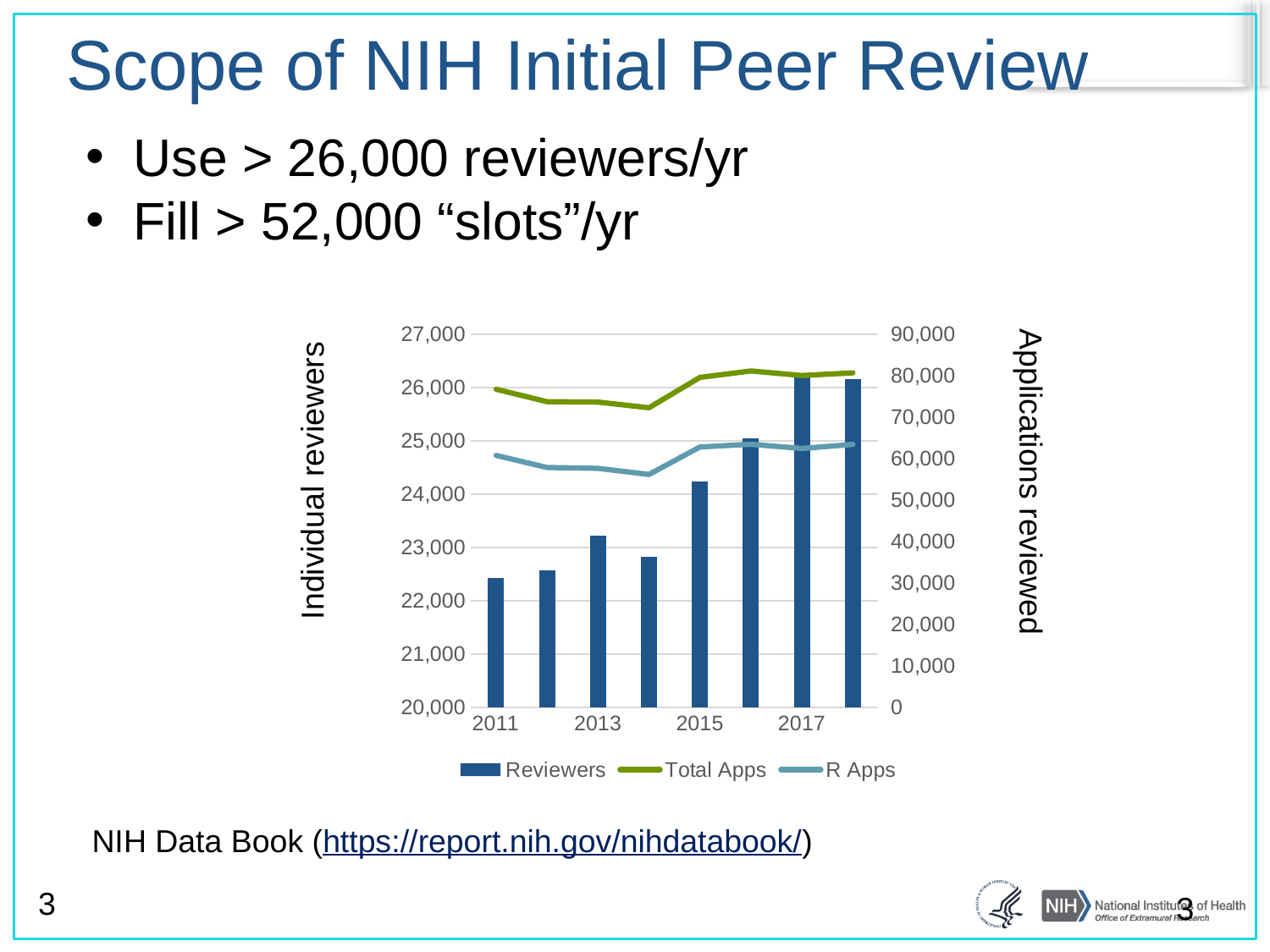
How many series does the chart legend list? 3 Is the R Apps value in 2011 greater or less than 70,000? less Is the number of Reviewers in 2017 greater or less than 26,000? greater What is the label of the left vertical axis? Individual reviewers What kind of chart is shown on the slide? Combined bar and line chart Is the number of Reviewers in 2011 greater or less than 23,000? less Do the Reviewers values generally rise or fall from 2011 to 2017? rise What are the three series named in the chart legend? Reviewers, Total Apps, R Apps Which year has more Reviewers, 2013 or 2015? 2015 How many bars (years) are plotted for the Reviewers series? 8